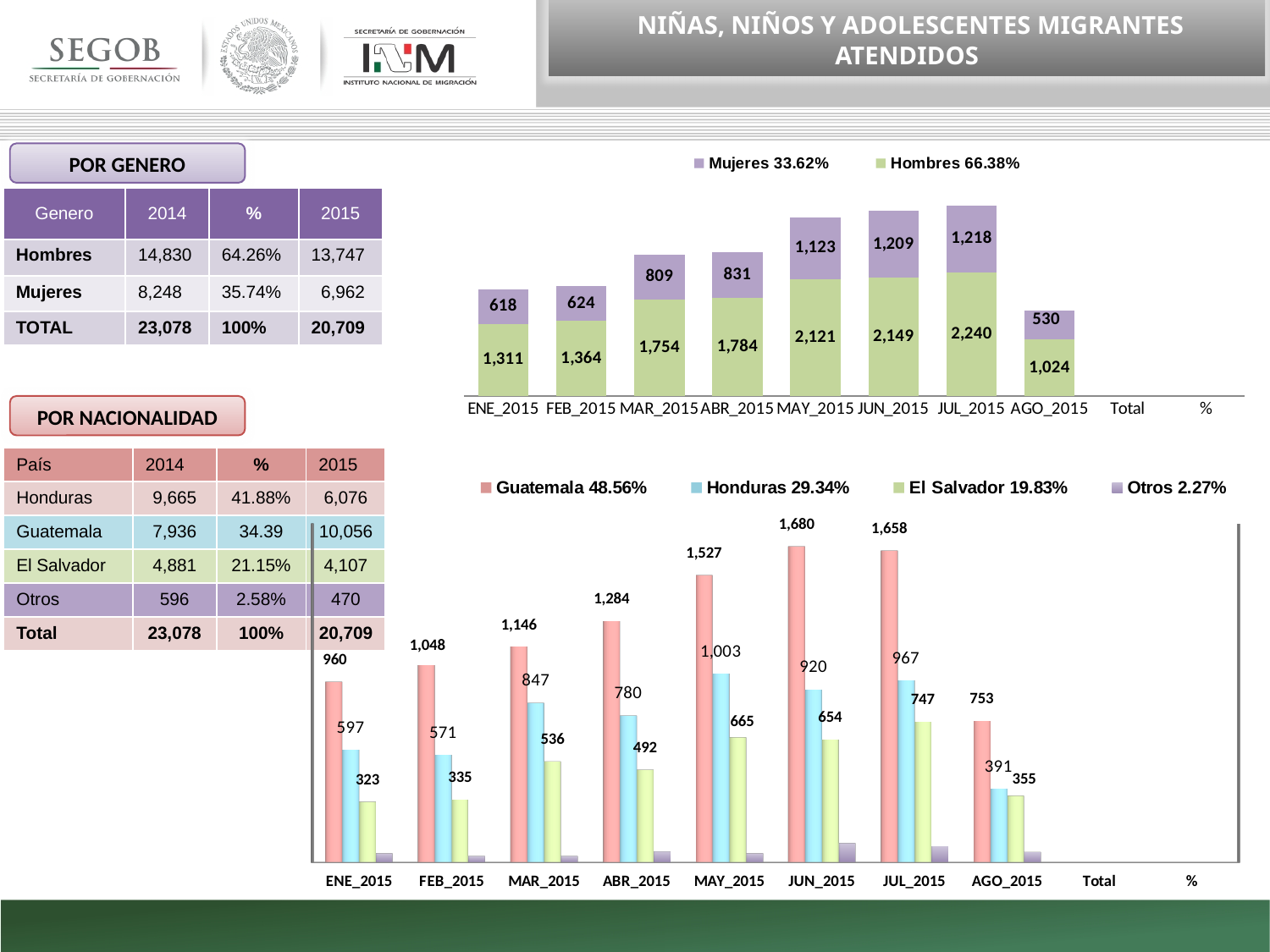
In the bottom chart (Guatemala/Honduras/El Salvador/Otros), how many series does the legend list? 4 In the top chart (Mujeres/Hombres), what is the difference between the Hombres values for JUN_2015 and ENE_2015? 838 In the top chart (Mujeres/Hombres), what is the Mujeres value for MAY_2015? 1,123 In the bottom chart (Guatemala/Honduras/El Salvador/Otros), which is larger for MAR_2015: Honduras or El Salvador? Honduras In the top chart (Mujeres/Hombres), which month has the highest Hombres value? JUL_2015 In the top chart (Mujeres/Hombres), what percentage does the legend show for Hombres? 66.38% What kind of chart is the bottom chart (Guatemala/Honduras/El Salvador/Otros)? bar chart In the top chart (Mujeres/Hombres), what is the total of the stacked bar for ENE_2015? 1,929 In the bottom chart (Guatemala/Honduras/El Salvador/Otros), what is the El Salvador value for JUL_2015? 747 In the top chart (Mujeres/Hombres), what is the Hombres value for JUL_2015? 2,240 In the top chart (Mujeres/Hombres), which month has the lowest Mujeres value? AGO_2015 In the bottom chart (Guatemala/Honduras/El Salvador/Otros), what is the Guatemala value for JUN_2015? 1,680